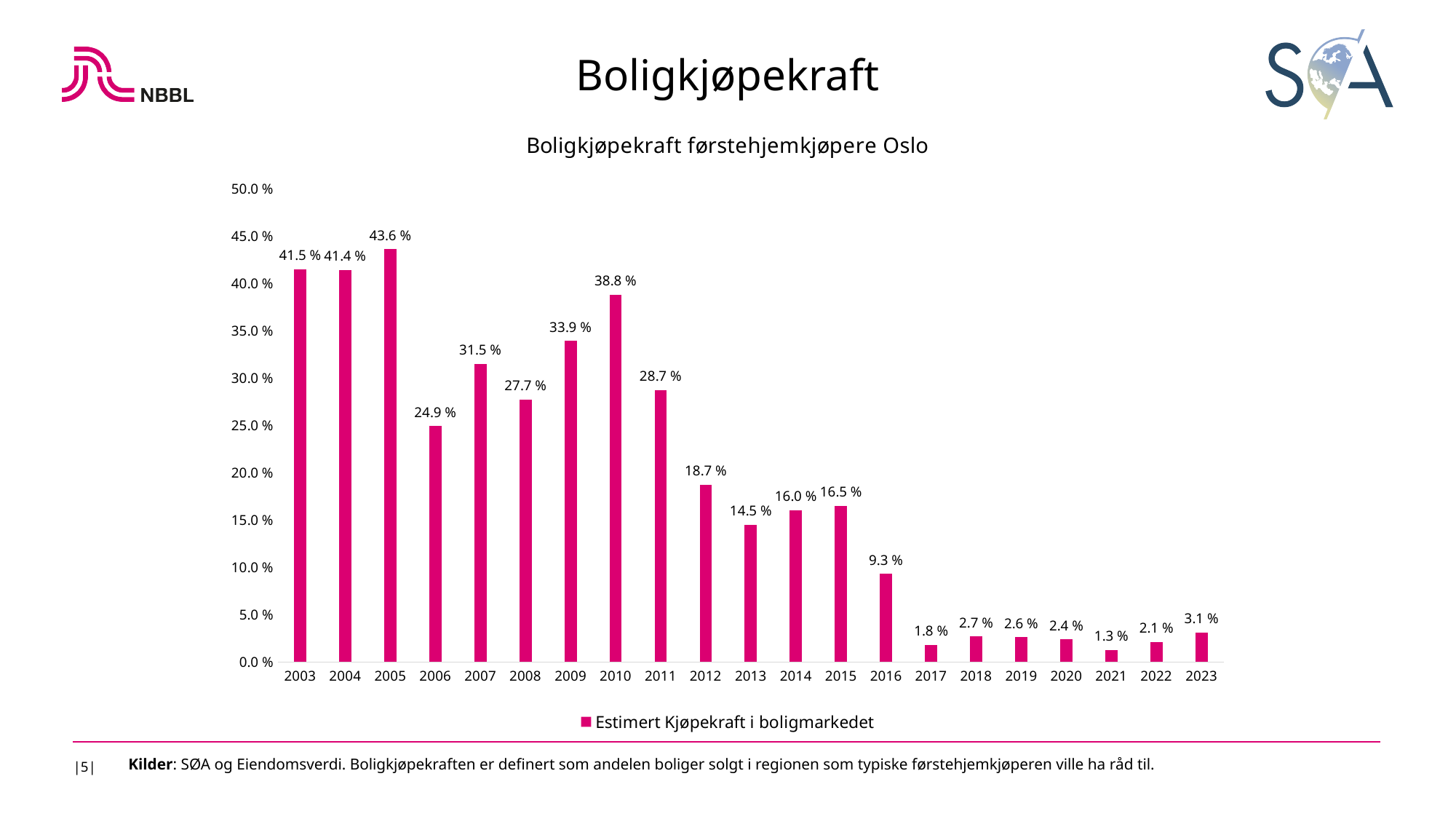
Is the value for 2012 greater or less than 20.0 %? less How many years are shown on the x axis? 21 Which is larger, the value for 2014 or the value for 2015? 2015 What is the value for 2005? 43.6 % Which year has the lowest value? 2021 What is the value for 2016? 9.3 % What is the value for 2023? 3.1 % How many series does the legend list? 1 Which year has the highest value? 2005 What kind of chart is shown? bar chart What is the difference between the values for 2010 and 2011? 10.1 % What is the title of the chart? Boligkjøpekraft førstehjemkjøpere Oslo